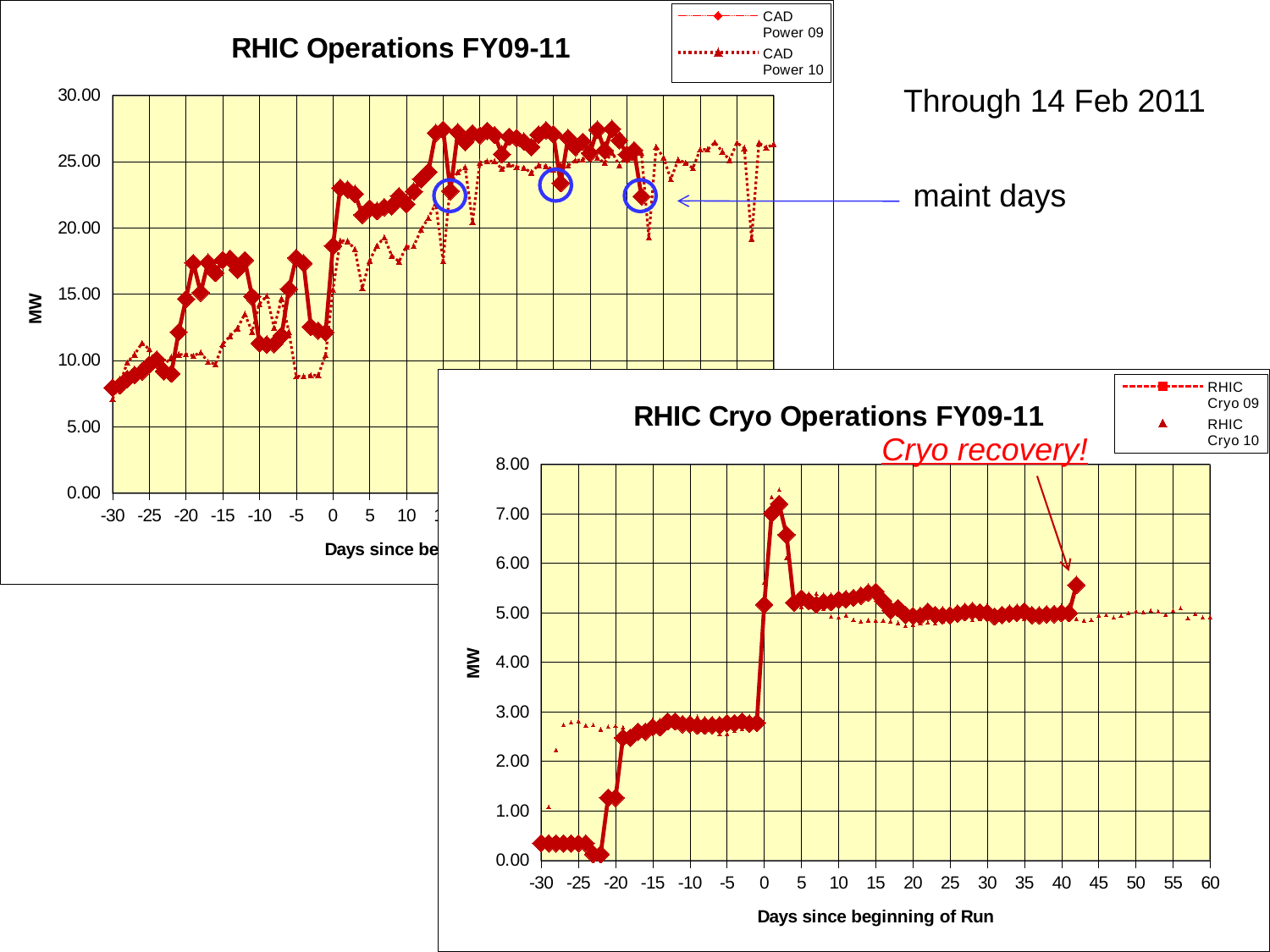
What are the names of the two series in the legend of the 'RHIC Cryo Operations FY09-11' chart? RHIC Cryo 09 and RHIC Cryo 10 In the 'RHIC Operations FY09-11' chart, is the CAD Power 09 value at day -30 greater or less than 10? less In the 'RHIC Cryo Operations FY09-11' chart, is the RHIC Cryo 09 value at day -30 greater or less than 1.00? less In the 'RHIC Operations FY09-11' chart, do the CAD Power 09 values generally rise or fall from day -30 to day 20? rise In the 'RHIC Cryo Operations FY09-11' chart, is the RHIC Cryo 09 value at day -10 greater or less than 3.00? less What is the y-axis label of the 'RHIC Cryo Operations FY09-11' chart? MW How many series does the legend of the 'RHIC Operations FY09-11' chart list? 2 What kind of chart is the 'RHIC Cryo Operations FY09-11' chart? line chart How many series does the legend of the 'RHIC Cryo Operations FY09-11' chart list? 2 What kind of chart is the 'RHIC Operations FY09-11' chart? line chart